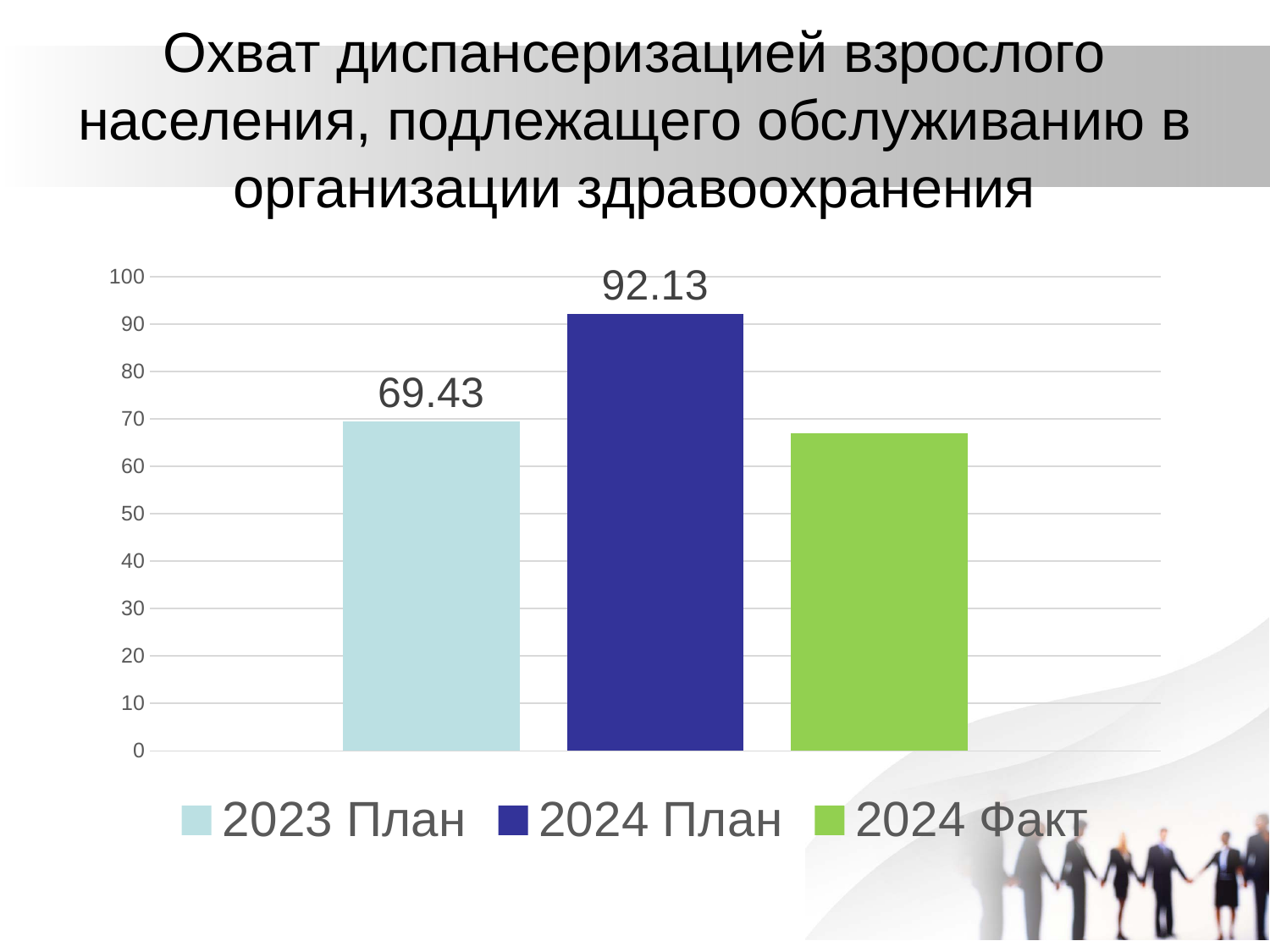
What is the difference between the 2024 План and 2023 План values? 22.70 What kind of chart is shown on the slide? bar chart Is the value for 2024 План greater or less than 90? greater How many series does the legend list? 3 What colour is the bar for 2024 Факт? green How many bars are plotted in the chart? 3 Which is larger, the value for 2024 План or the value for 2023 План? 2024 План What is the value for 2023 План? 69.43 Is the value for 2024 Факт greater or less than 70? less Which series has the highest value? 2024 План What is the value for 2024 План? 92.13 Is the value for 2024 Факт greater or less than 60? greater